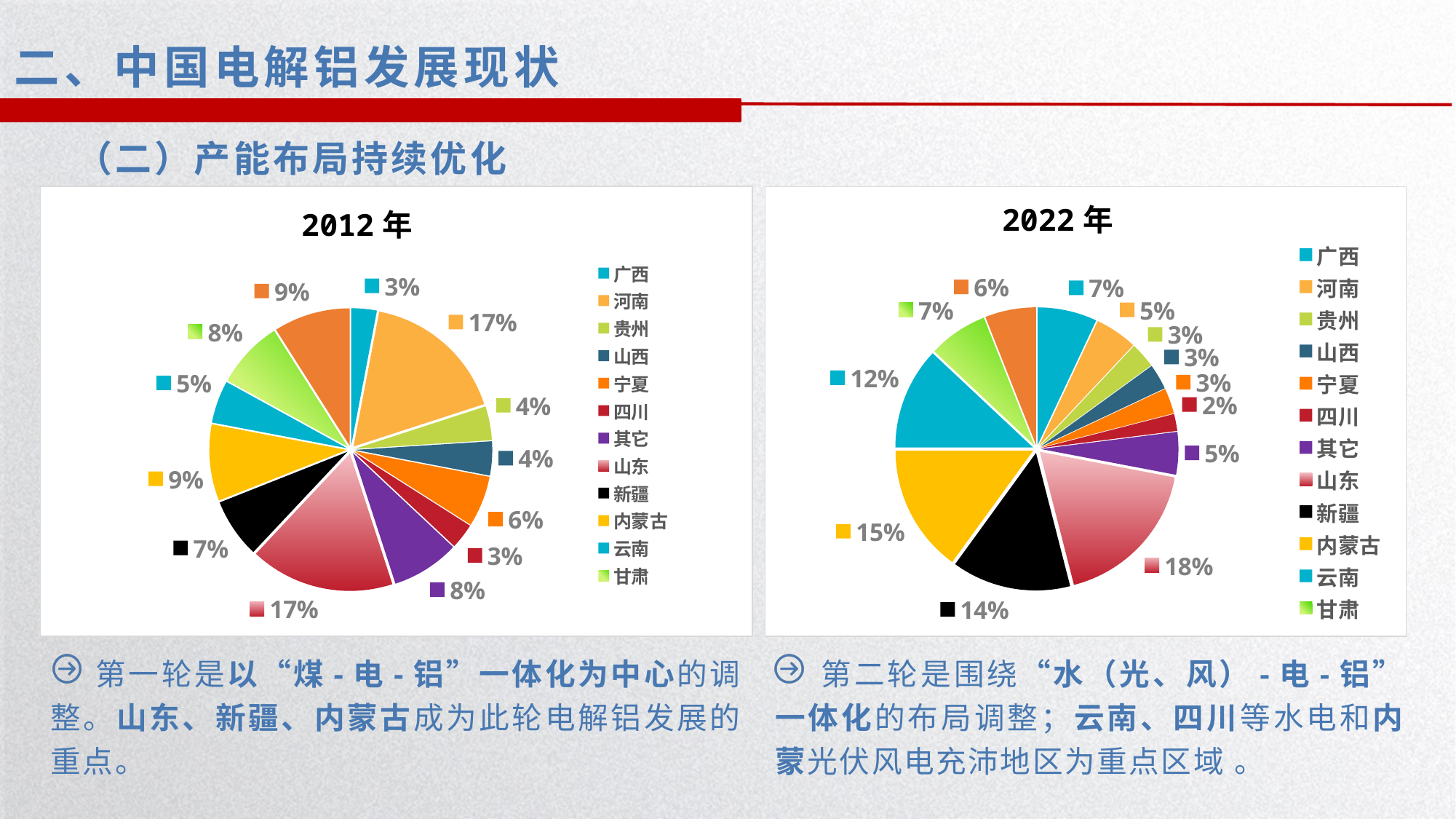
In the 2022年 chart, what share does 云南 have? 12% Is the share of 云南 larger in the 2012年 chart or the 2022年 chart? 2022年 In the 2012年 chart, what share does 河南 have? 17% In the 2022年 chart, which province has the smallest share? 四川 In the 2012年 chart, what share does 内蒙古 have? 9% What type of chart is used for the 2012年 chart? pie chart What is the title of the chart on the right? 2022 年 In the 2022年 chart, which province has the largest share? 山东 In the 2022年 chart, what share does 山东 have? 18% In the 2022年 chart, what is the difference between the shares of 山东 and 新疆? 4 percentage points In the 2022年 chart, which is larger, the share of 内蒙古 or the share of 广西? 内蒙古 In the 2012年 chart, what share does 新疆 have? 7%